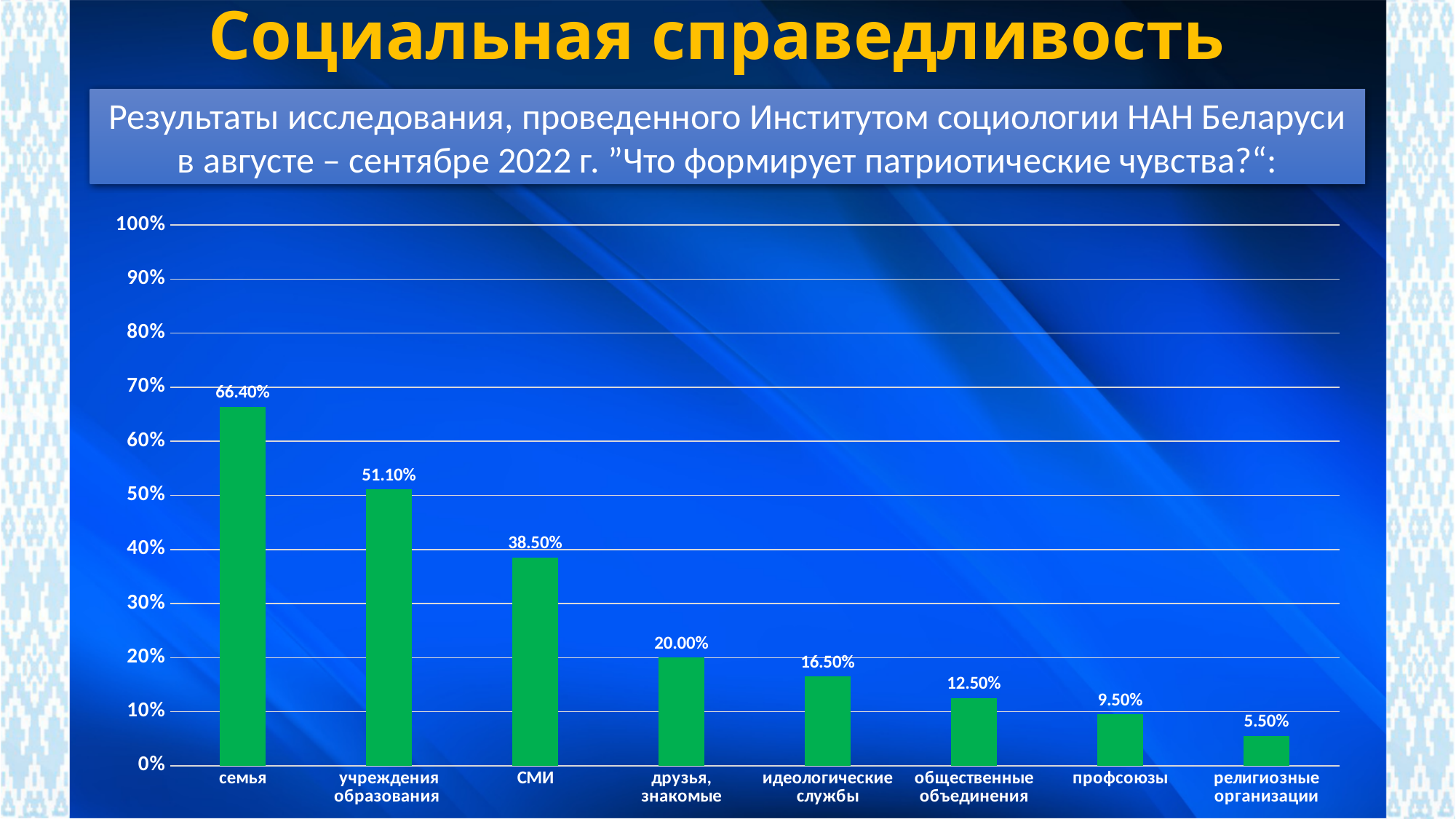
Which category has the highest value? семья How many categories are shown on the chart? 8 What is the value for профсоюзы? 9.50% What is the difference between the values for друзья, знакомые and общественные объединения? 7.50% Which category has the lowest value? религиозные организации What is the difference between the values for семья and учреждения образования? 15.30% What is the value for семья? 66.40% Do the values rise or fall from left to right along the x axis? fall What is the value for СМИ? 38.50% What kind of chart is shown on the slide? bar chart What is the value for идеологические службы? 16.50% Which is larger, the value for СМИ or the value for друзья, знакомые? СМИ